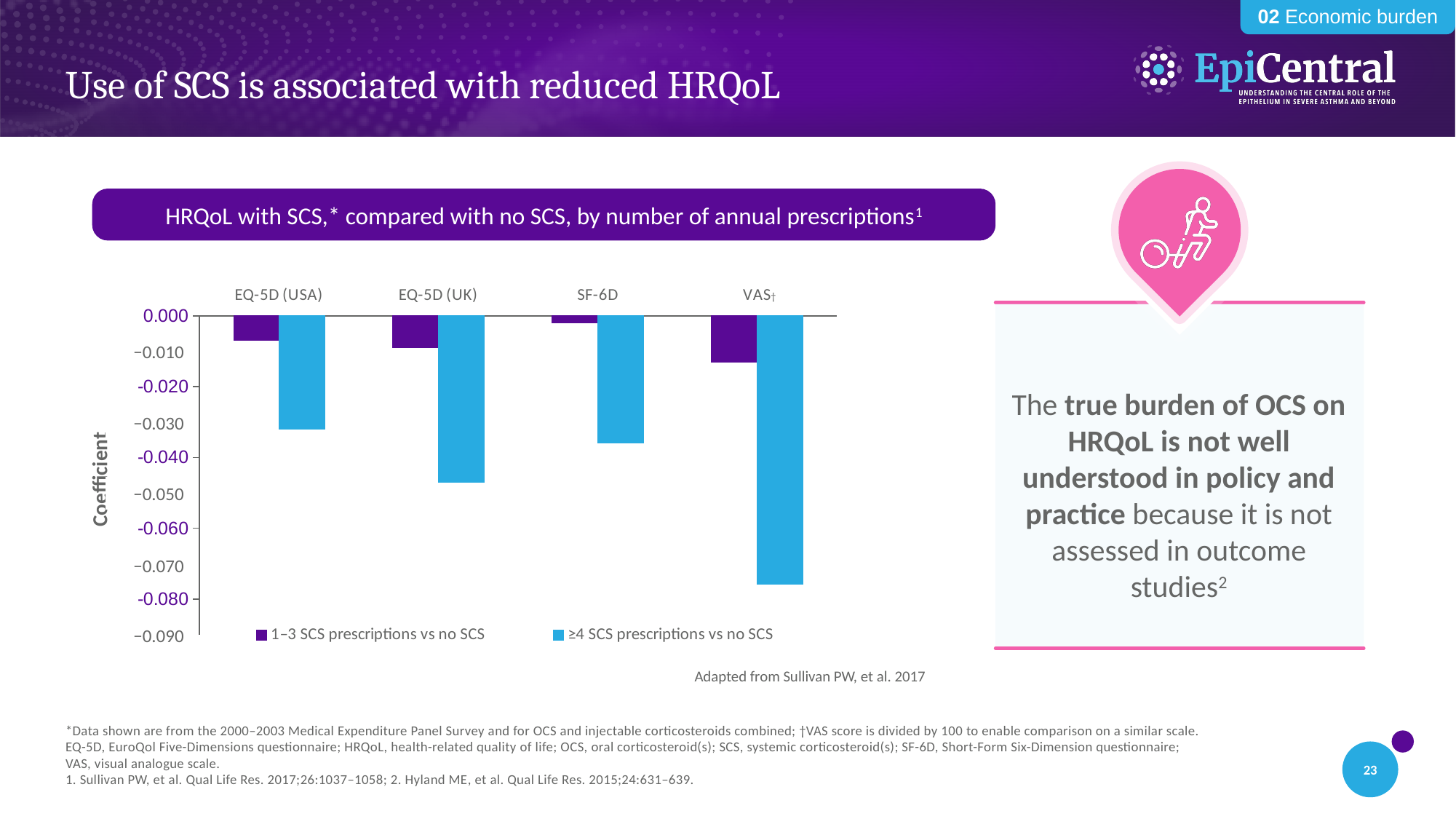
For ≥4 SCS prescriptions vs no SCS, which has the more negative coefficient: EQ-5D (USA) or EQ-5D (UK)? EQ-5D (UK) Which category has the lowest (most negative) coefficient for ≥4 SCS prescriptions vs no SCS? VAS Is the coefficient for 1–3 SCS prescriptions vs no SCS for VAS greater or less than -0.020? greater Is the coefficient for ≥4 SCS prescriptions vs no SCS for SF-6D greater or less than -0.040? greater What are the two series named in the chart legend? 1–3 SCS prescriptions vs no SCS; ≥4 SCS prescriptions vs no SCS How many series does the chart legend list? 2 What is the label on the vertical axis of the chart? Coefficient Is the coefficient for ≥4 SCS prescriptions vs no SCS for VAS greater or less than -0.070? less Which category has the coefficient closest to zero for 1–3 SCS prescriptions vs no SCS? SF-6D What kind of chart is shown on the slide? Bar chart How many categories (questionnaires) are shown on the x axis of the chart? 4